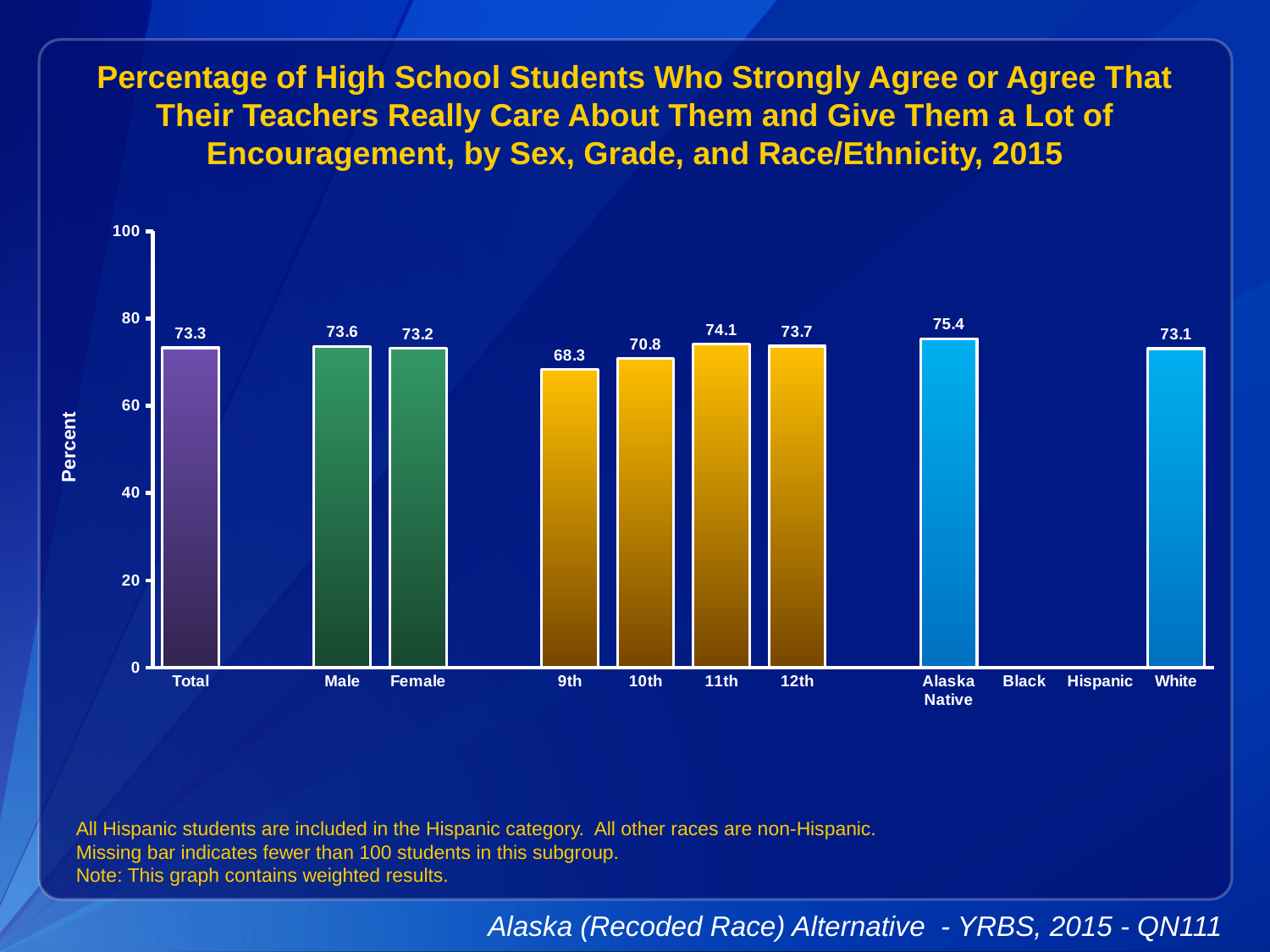
Is the value for Female greater or less than 60? greater Do the values rise or fall from 9th grade to 11th grade? rise What is the difference between the values for 11th and 9th grade? 5.8 What is the value for White students? 73.1 What is the value for Total? 73.3 What is the value for 9th grade students? 68.3 What is the value for Alaska Native students? 75.4 Which category has the highest value? Alaska Native What kind of chart is shown? bar chart Which is larger, the value for 10th grade or the value for 12th grade? 12th How many bars are plotted on the chart? 9 Which category has the lowest value? 9th